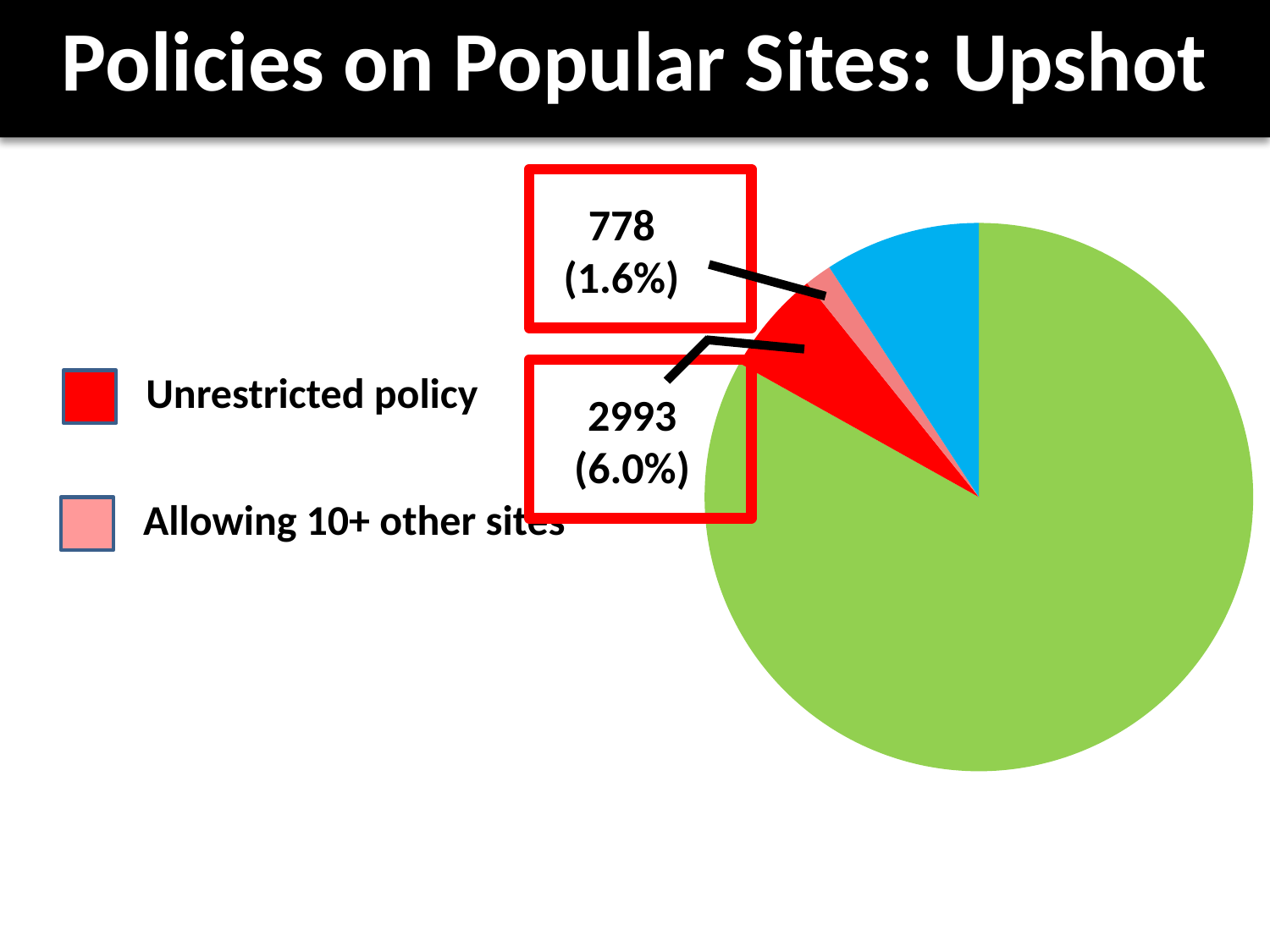
What is the value for Allowing 10+ other sites? 778 What kind of chart is shown on the slide? pie chart How many entries does the legend list? 2 What share of the pie does Unrestricted policy represent? 6.0% What share of the pie does Allowing 10+ other sites represent? 1.6% Which is larger, Unrestricted policy or Allowing 10+ other sites? Unrestricted policy What is the difference between the values for Unrestricted policy and Allowing 10+ other sites? 2215 What is the value for Unrestricted policy? 2993 How many slices does the pie chart have? 4 What is the title of the slide? Policies on Popular Sites: Upshot Of the two labelled slices, which has the smaller value? Allowing 10+ other sites